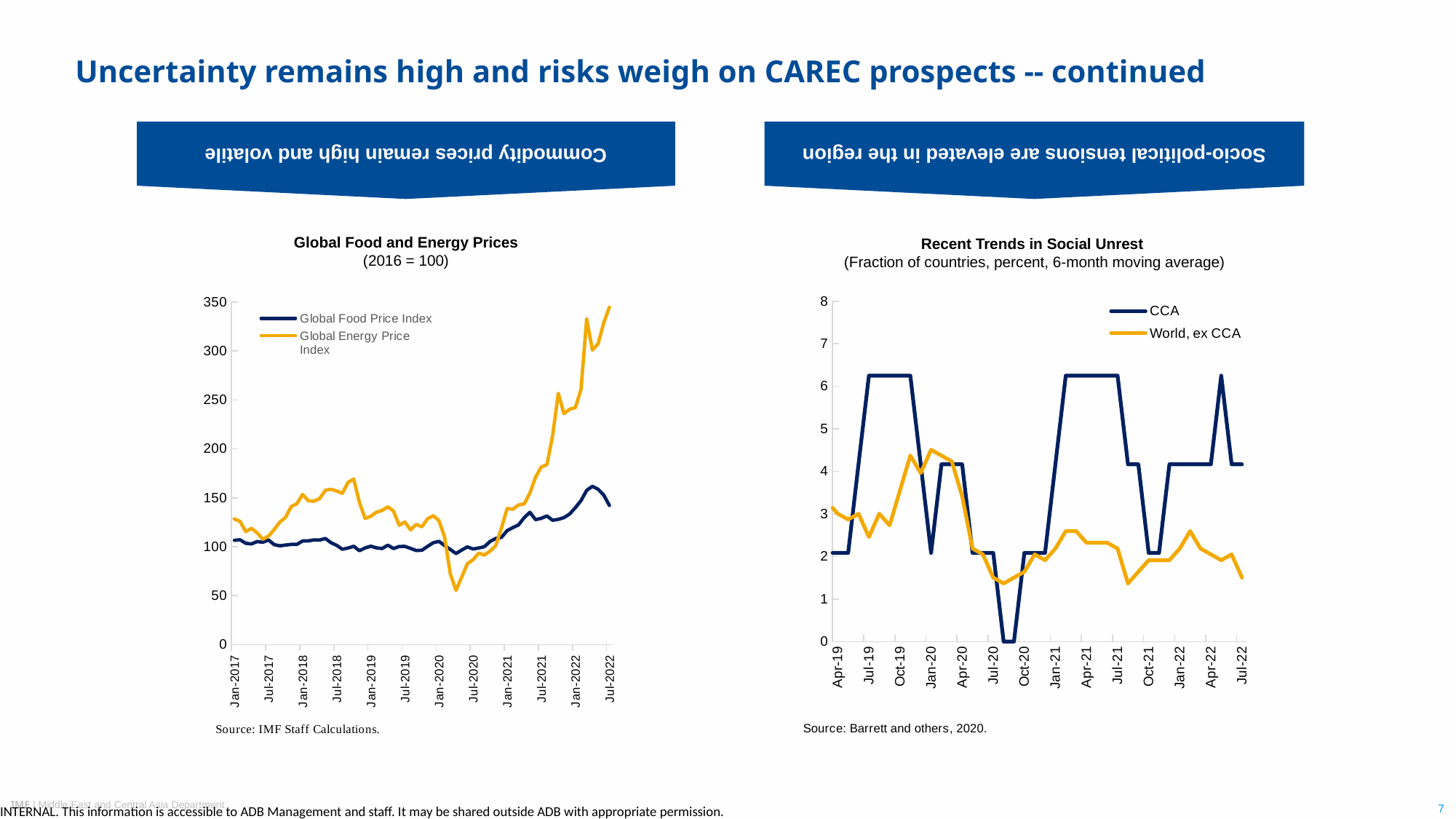
How many series does the legend of the 'Global Food and Energy Prices' chart list? 2 In the 'Global Food and Energy Prices' chart, is the Global Food Price Index at Jan-2017 greater or less than 150? less In the 'Global Food and Energy Prices' chart, which series is higher at Jul-2022, the Global Food Price Index or the Global Energy Price Index? Global Energy Price Index In the 'Global Food and Energy Prices' chart, is the Global Energy Price Index at Jul-2022 greater or less than 300? greater What kind of chart is the 'Recent Trends in Social Unrest' chart on the right? line chart In the 'Recent Trends in Social Unrest' chart, is the World, ex CCA value at Jul-22 greater or less than 2? less What base year is given in the subtitle of the 'Global Food and Energy Prices' chart? 2016 = 100 In the 'Recent Trends in Social Unrest' chart, which series is higher at Jul-19, CCA or World, ex CCA? CCA How many series does the legend of the 'Recent Trends in Social Unrest' chart list? 2 In the 'Global Food and Energy Prices' chart, does the Global Energy Price Index rise or fall between Jan-2021 and Jul-2022? rise What kind of chart is the 'Global Food and Energy Prices' chart on the left? line chart